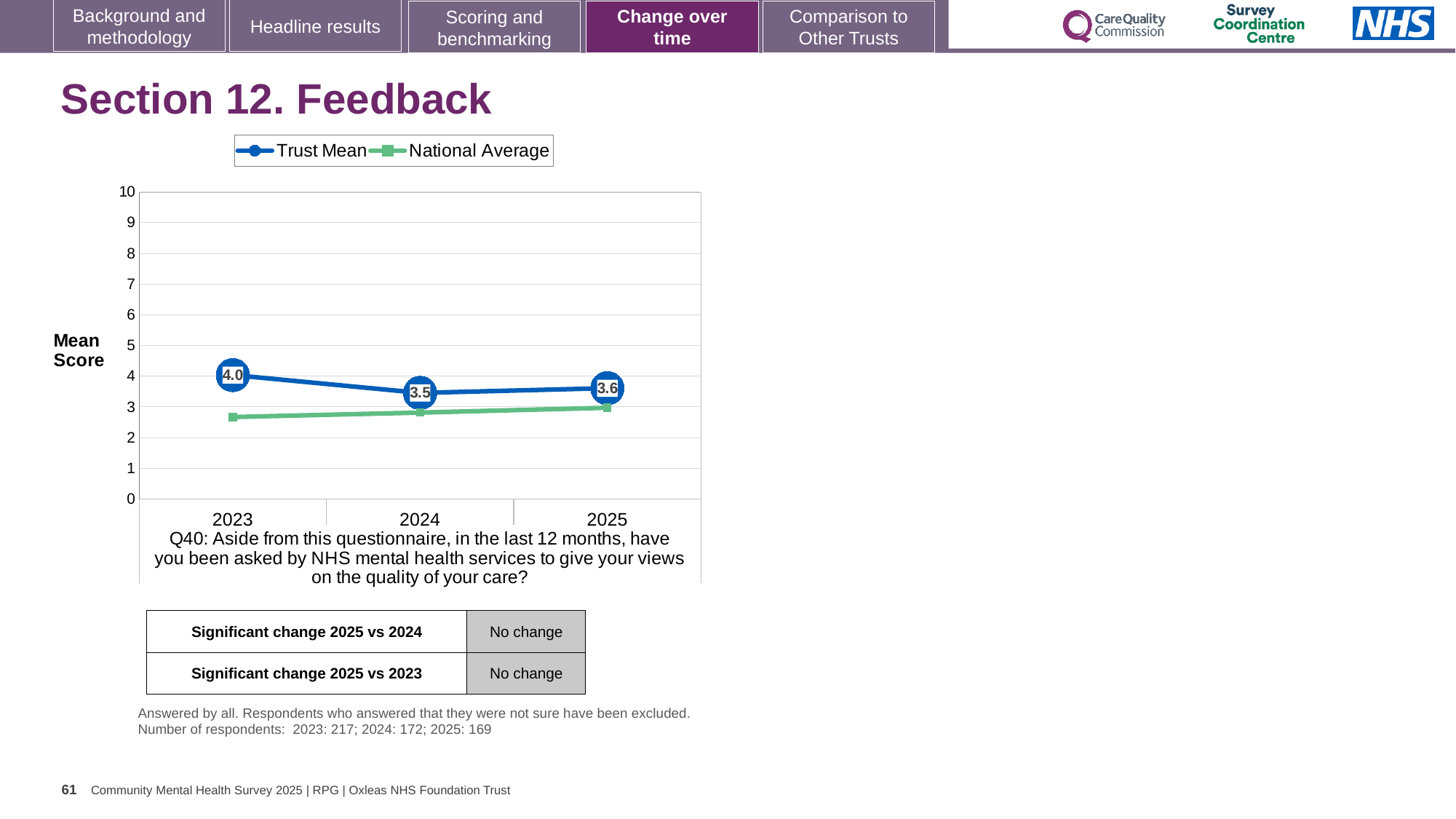
In which year is the Trust Mean lowest? 2024 How many years are plotted on the x axis? 3 How many series does the legend list? 2 What is the Trust Mean score for 2025? 3.6 By how much did the Trust Mean fall from 2023 to 2024? 0.5 In 2023, which is larger: the Trust Mean or the National Average? Trust Mean What is the Trust Mean score for 2023? 4.0 What is the Trust Mean score for 2024? 3.5 Does the National Average rise or fall from 2023 to 2025? Rises Is the National Average for 2023 greater or less than 3? less What kind of chart is shown on the slide? Line chart In which year is the Trust Mean highest? 2023